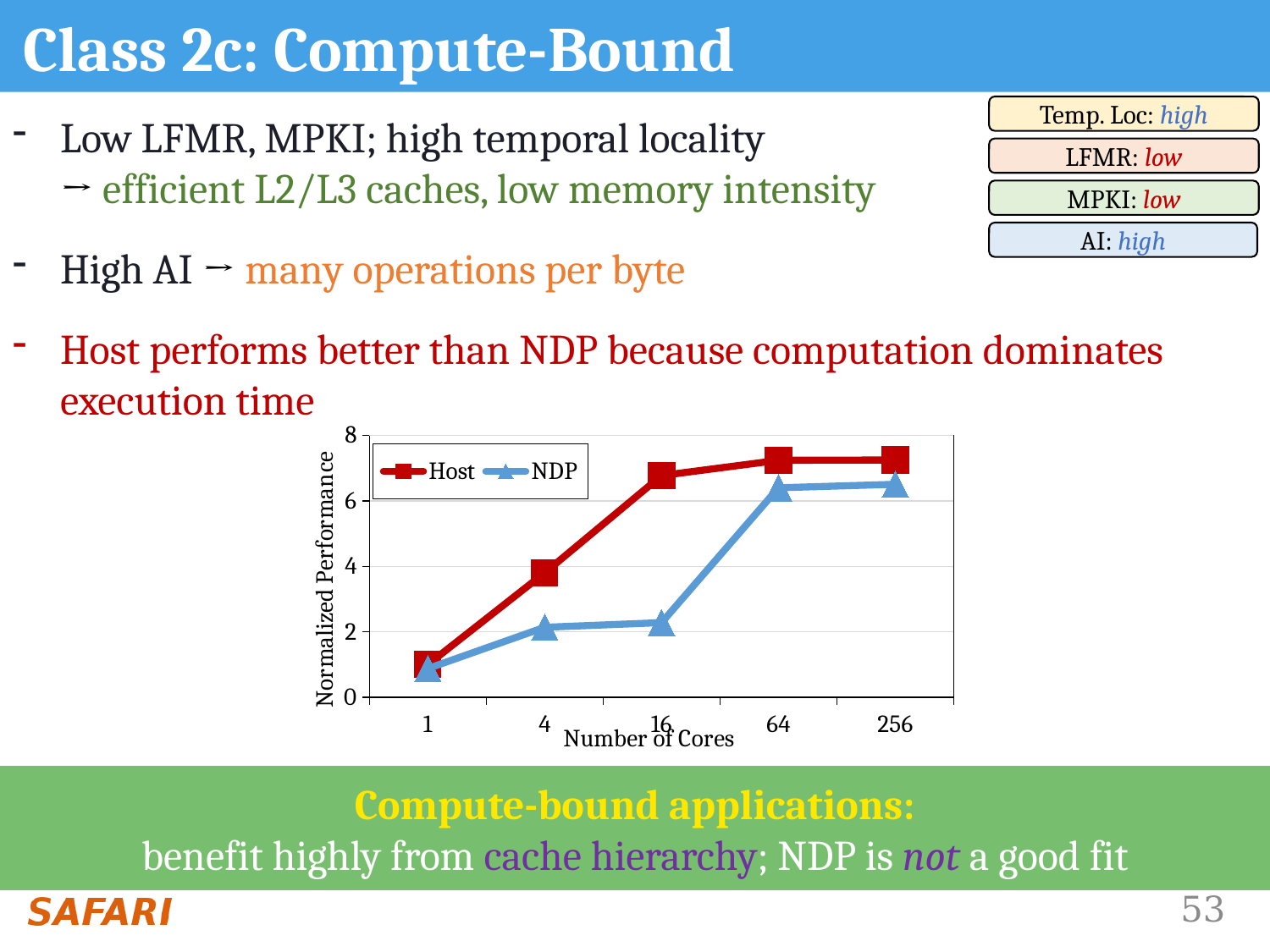
How many core counts are plotted along the x axis of the chart? 5 At 4 cores, which series has the higher normalized performance, Host or NDP? Host What is the label of the chart's y axis? Normalized Performance What is the label of the chart's x axis? Number of Cores Does the Host series rise or fall as the number of cores increases? rise Is the NDP value at 16 cores greater or less than 4? less Is the Host value at 4 cores greater or less than 2? greater At 16 cores, which series has the higher normalized performance, Host or NDP? Host What kind of chart is shown on the slide? line chart How many series does the chart's legend list? 2 Is the Host value at 16 cores greater or less than 6? greater